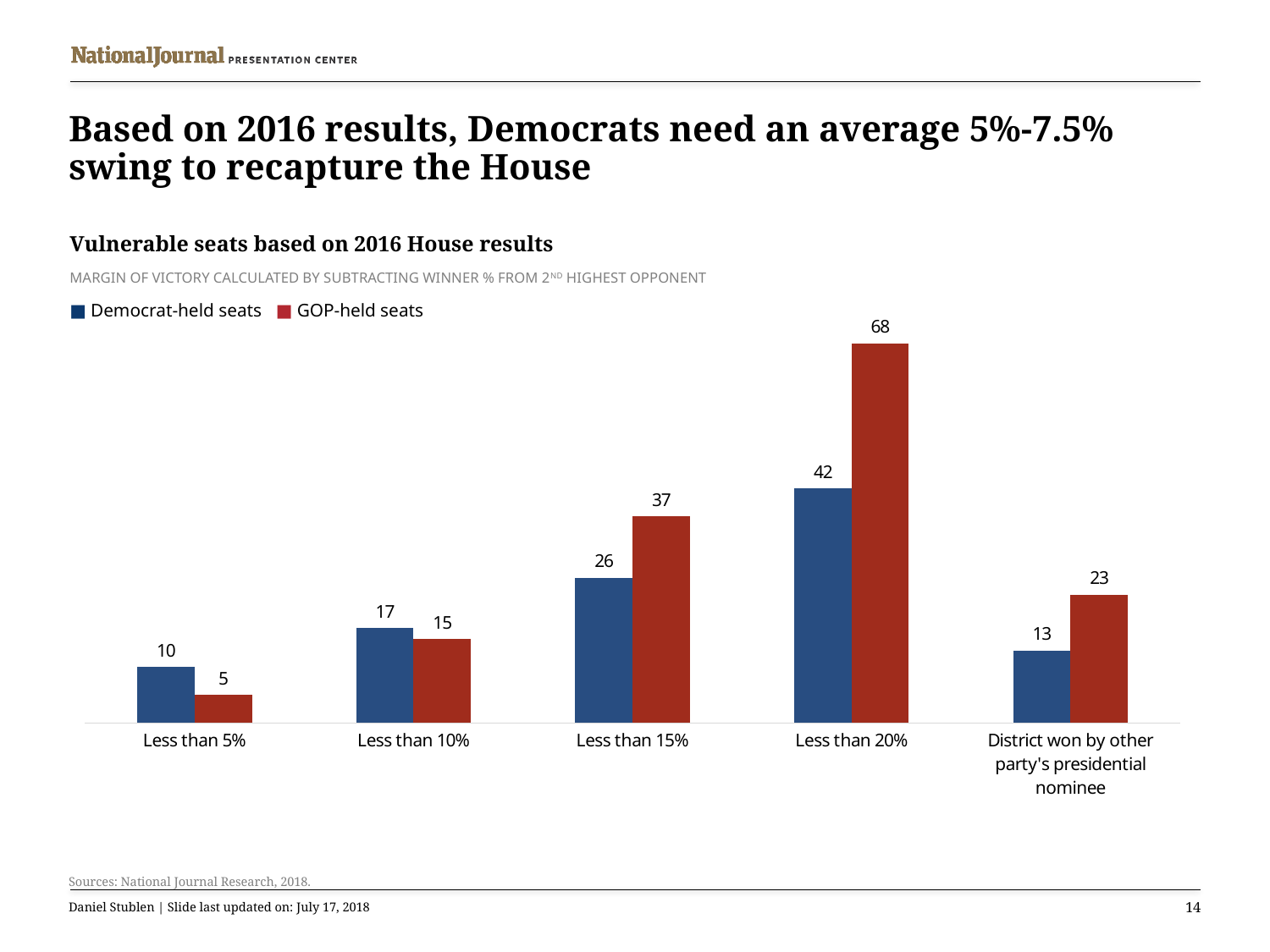
How many categories are shown on the x axis? 5 How many series does the legend list? 2 In the "Less than 10%" category, which series has the larger value, Democrat-held seats or GOP-held seats? Democrat-held seats What is the title of the chart? Vulnerable seats based on 2016 House results How many Democrat-held seats are in the "Less than 5%" category? 10 What is the difference between GOP-held and Democrat-held seats in the "Less than 20%" category? 26 What is the difference between Democrat-held seats in the "Less than 15%" and "Less than 10%" categories? 9 Which category has the highest number of GOP-held seats? Less than 20% What type of chart is shown on the slide? Bar chart What is the value for GOP-held seats in the "District won by other party's presidential nominee" category? 23 How many GOP-held seats are in the "Less than 20%" category? 68 Which category has the lowest number of Democrat-held seats? Less than 5%